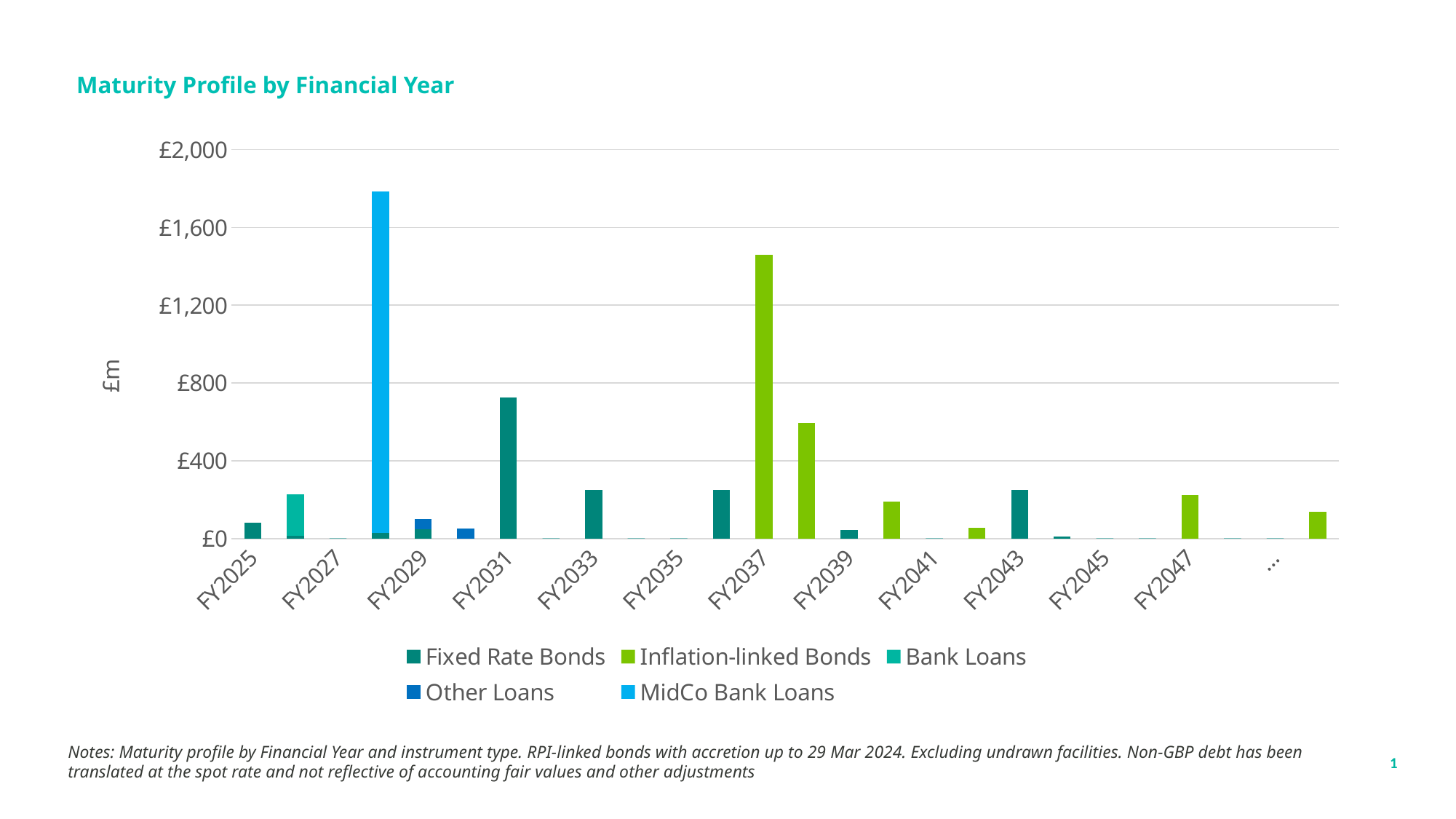
Is the tallest Fixed Rate Bonds bar greater or less than £800? less Which is larger: the Fixed Rate Bonds bar at FY2031 or the Fixed Rate Bonds bar at FY2025? FY2031 Is the Fixed Rate Bonds bar at FY2031 greater or less than £400? greater Which series has the tallest bar in the chart? MidCo Bank Loans Is the tallest Inflation-linked Bonds bar greater or less than £1,200? greater How many series does the legend list? 5 What unit is shown on the y-axis label? £m What kind of chart is shown on the slide? Bar chart What is the title of the chart? Maturity Profile by Financial Year Which is larger: the tallest MidCo Bank Loans bar or the tallest Inflation-linked Bonds bar? MidCo Bank Loans